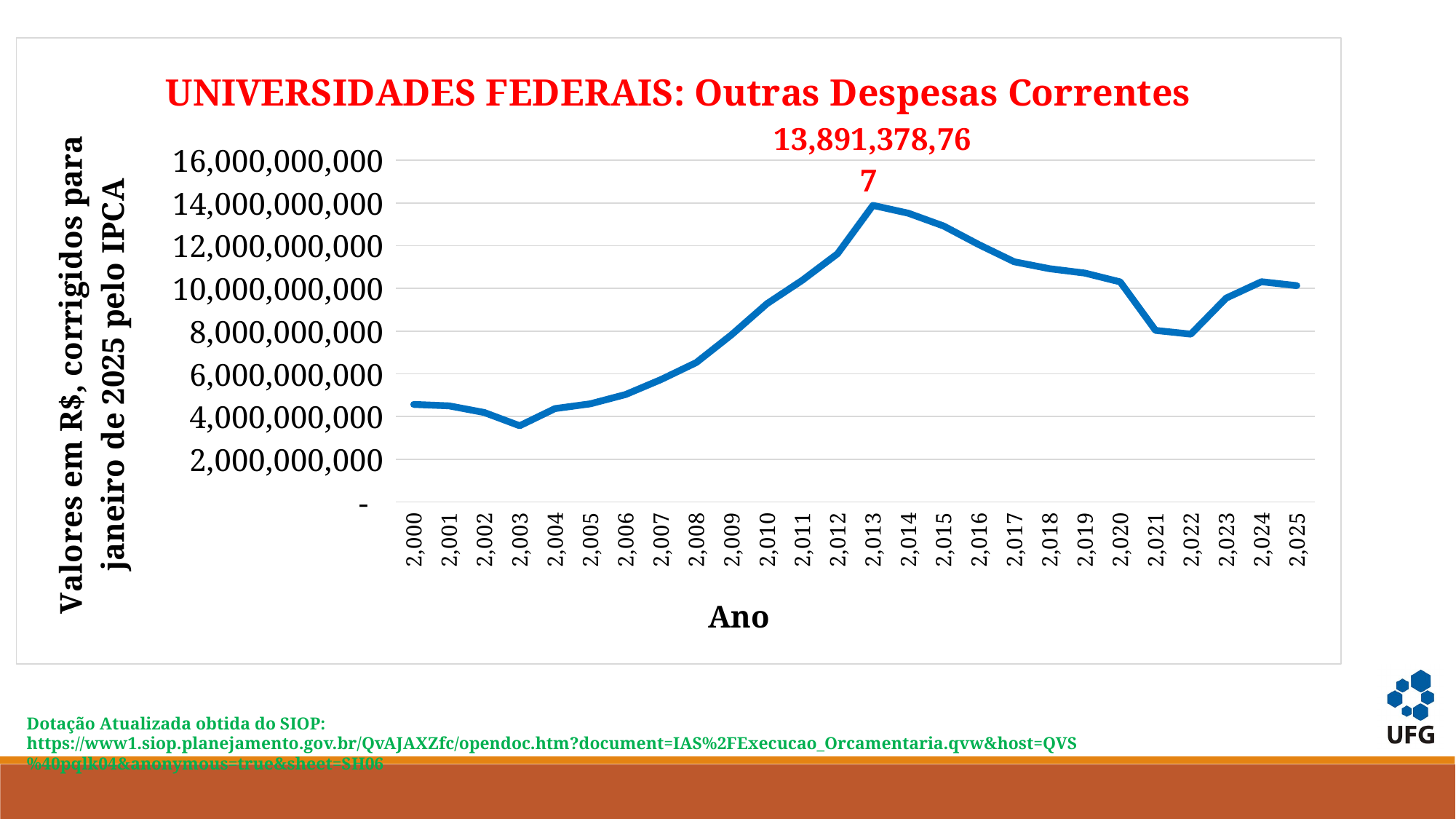
Do the values rise or fall from 2003 to 2013? rise What is the title of the chart? UNIVERSIDADES FEDERAIS: Outras Despesas Correntes How many years are plotted along the x axis? 26 Is the value for 2000 greater or less than 6,000,000,000? less Is the value for 2021 greater or less than 10,000,000,000? less What is the value labelled at the peak in 2013? 13,891,378,767 Which year has the larger value, 2013 or 2025? 2013 In which year is the value highest? 2013 Which year has the larger value, 2003 or 2021? 2021 Is the value for 2015 greater or less than 12,000,000,000? greater What kind of chart is shown on the slide? line chart In which year is the value lowest? 2003